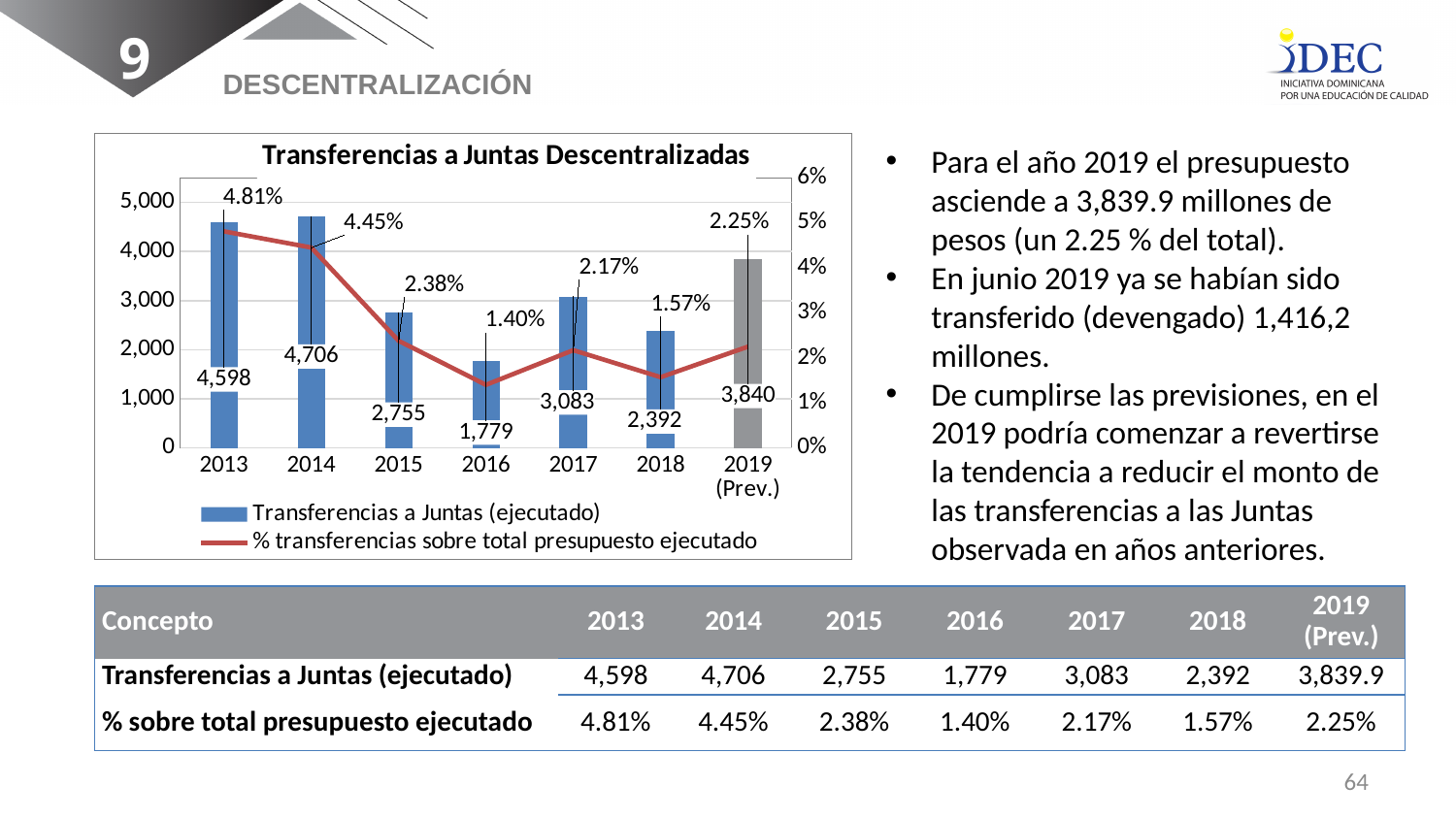
What is the projected value of Transferencias a Juntas for 2019 (Prev.)? 3,840 Did the percentage of transfers over total executed budget rise or fall from 2013 to 2016? Fall Is the Transferencias a Juntas value for 2016 greater or less than 2,000? less Which year has the highest value of Transferencias a Juntas (ejecutado)? 2014 What is the difference between the Transferencias a Juntas values for 2017 and 2018? 691 How many series does the chart legend list? 2 How many years are shown on the x axis of the chart? 7 What is the value of Transferencias a Juntas (ejecutado) for 2014? 4,706 What kind of chart is used to show the Transferencias a Juntas (ejecutado) series? Bar chart Which is larger, the Transferencias a Juntas value for 2015 or for 2017? 2017 What percentage of the total executed budget did transfers to Juntas represent in 2016? 1.40% Which year has the lowest percentage of transfers over total executed budget? 2016